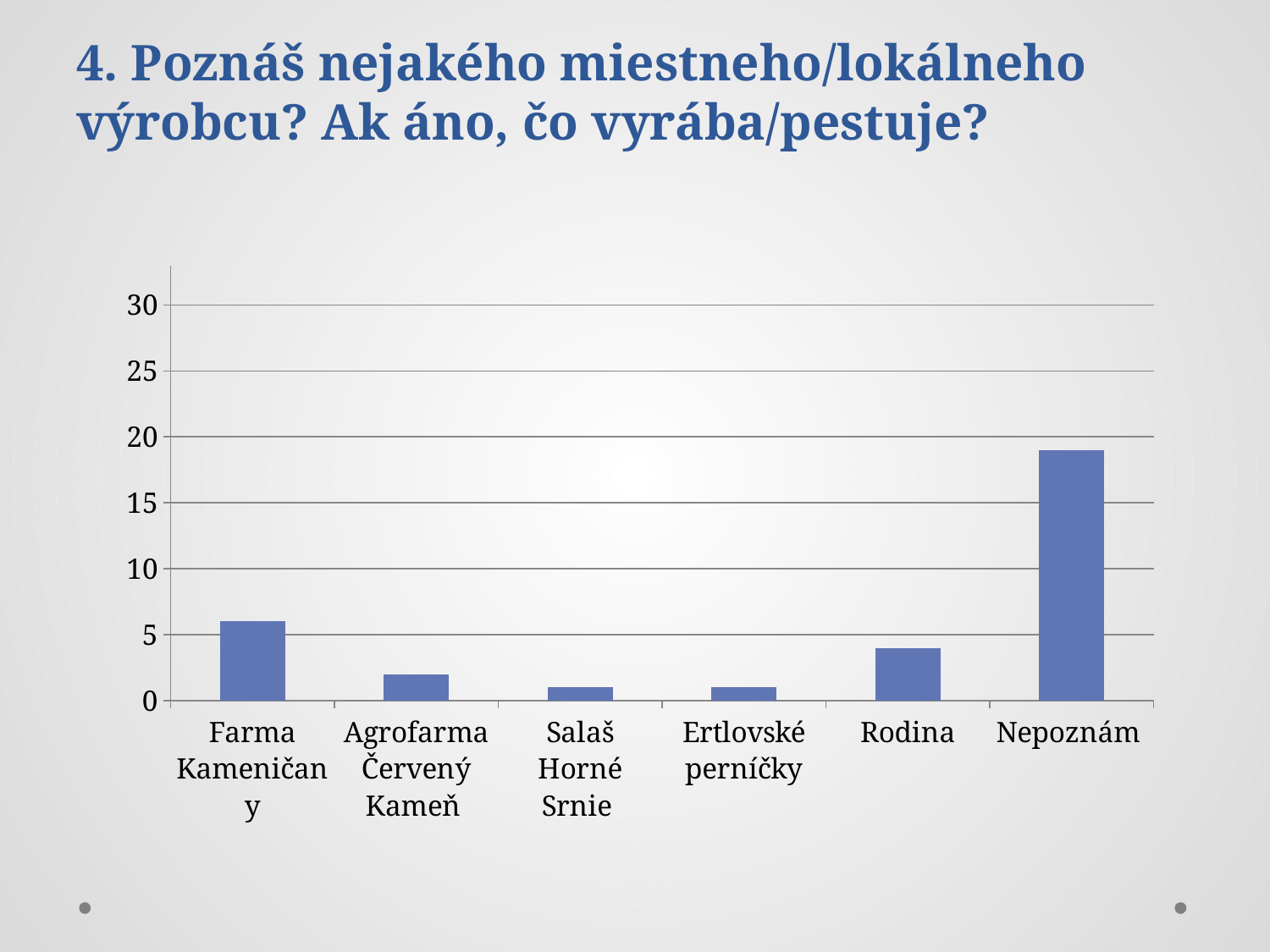
What is the highest value shown on the vertical axis of the chart? 30 What kind of chart is shown on the slide? bar chart Is the value for Rodina greater or less than 5? less How many categories are shown on the x axis of the chart? 6 Which is larger, the value for Farma Kameničany or the value for Rodina? Farma Kameničany Which category has the highest bar in the chart? Nepoznám Is the value for Nepoznám greater or less than 20? less Which is larger, the value for Agrofarma Červený Kameň or the value for Salaš Horné Srnie? Agrofarma Červený Kameň What colour are the bars in the chart? blue Is the value for Agrofarma Červený Kameň greater or less than 5? less